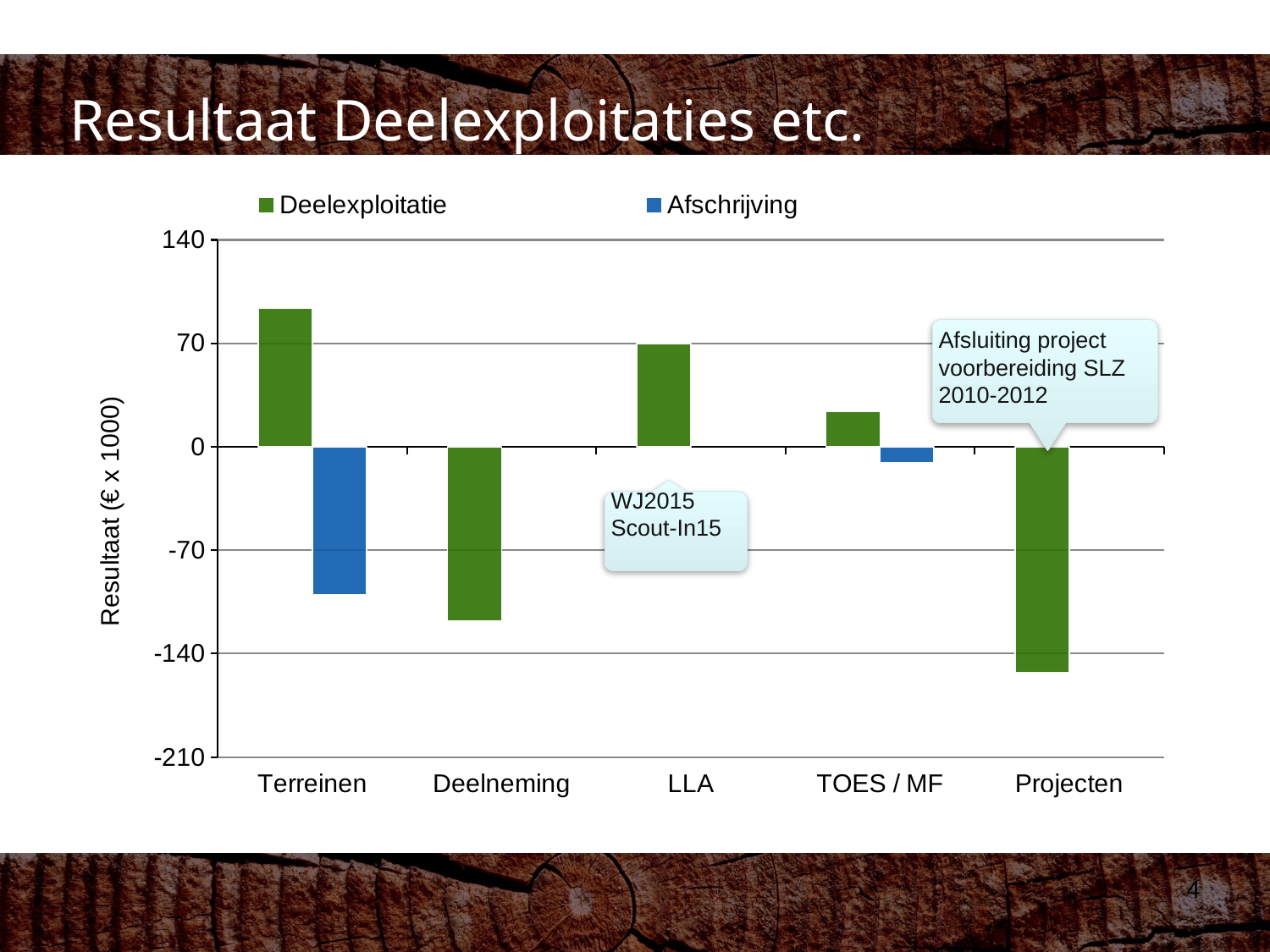
What is the label of the vertical axis? Resultaat (€ x 1000) What is the title of the slide containing the chart? Resultaat Deelexploitaties etc. Is the Afschrijving value for Terreinen greater or less than -70? less Is the Deelexploitatie value for Projecten greater or less than -140? less How many categories are shown on the x axis? 5 Which is larger, the Deelexploitatie value for LLA or for TOES / MF? LLA What kind of chart is shown on the slide? bar chart Which category has the lowest Deelexploitatie value? Projecten Is the Deelexploitatie value for Terreinen greater or less than 70? greater Which category has the highest Deelexploitatie value? Terreinen How many series does the legend list? 2